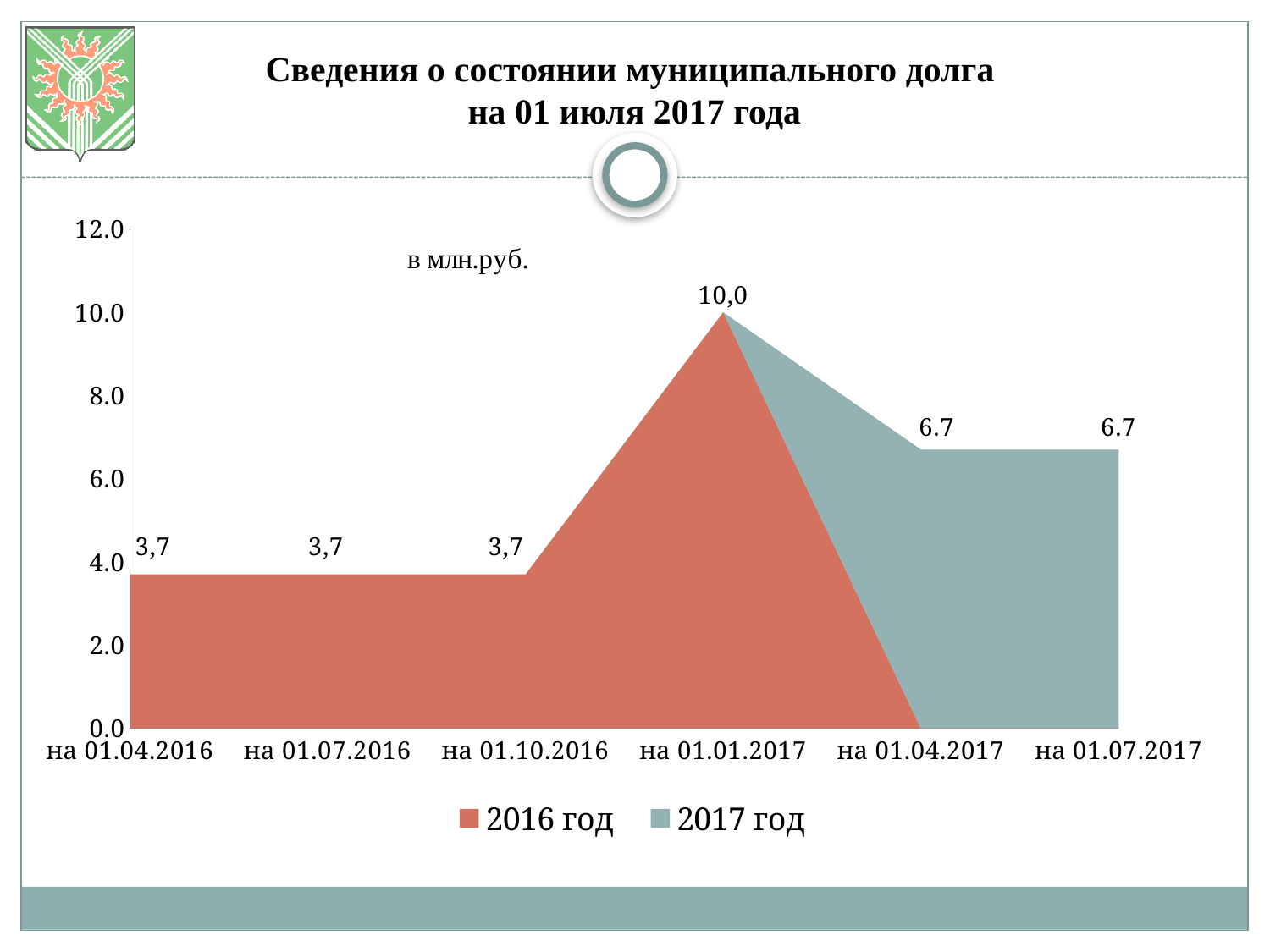
What kind of chart is shown on the slide? area chart Which date has the highest value on the chart? на 01.01.2017 Which is larger, the value at на 01.07.2016 or the value at на 01.07.2017? на 01.07.2017 What is the difference between the value at на 01.04.2017 and the value at на 01.10.2016? 3,0 What is the value shown for на 01.04.2016? 3,7 What is the difference between the value at на 01.01.2017 and the value at на 01.04.2017? 3,3 How many dates are shown on the x axis? 6 Is the value for на 01.04.2017 greater or less than 8.0? less What is the value shown for на 01.01.2017? 10,0 What is the value shown for на 01.07.2017? 6.7 How many series does the legend list? 2 What unit is stated on the chart? в млн.руб.